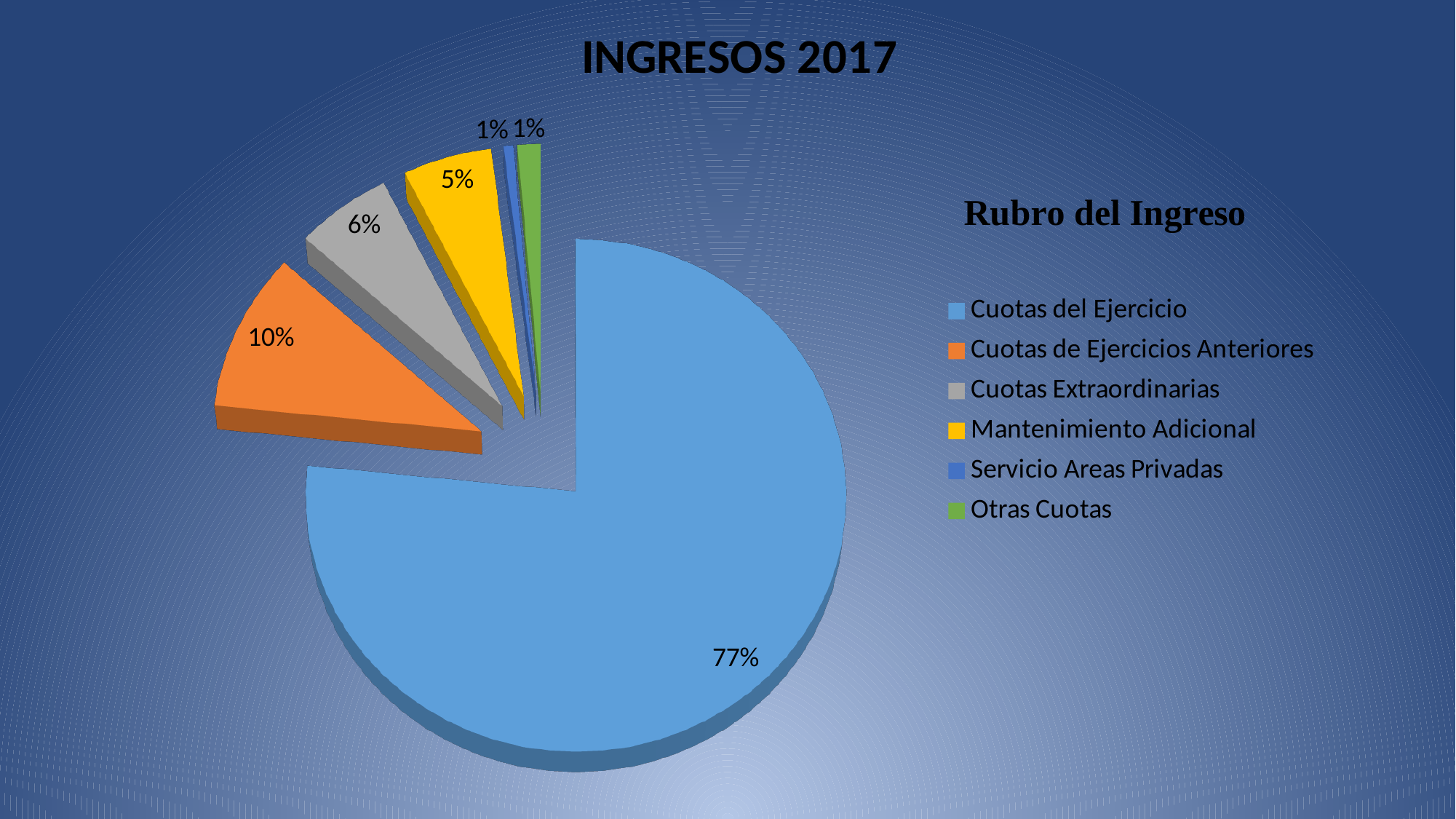
What share of the pie does Otras Cuotas represent? 1% What share of the pie does Cuotas del Ejercicio represent? 77% How many categories does the pie chart show? 6 What share of the pie does Cuotas Extraordinarias represent? 6% What colour is the slice for Mantenimiento Adicional? Yellow Which is larger, the slice for Cuotas Extraordinarias or the slice for Mantenimiento Adicional? Cuotas Extraordinarias What is the title of the chart? INGRESOS 2017 Which category has the largest slice of the pie? Cuotas del Ejercicio What is the difference in percentage points between Cuotas del Ejercicio and Cuotas de Ejercicios Anteriores? 67 What kind of chart is shown on the slide? Pie chart